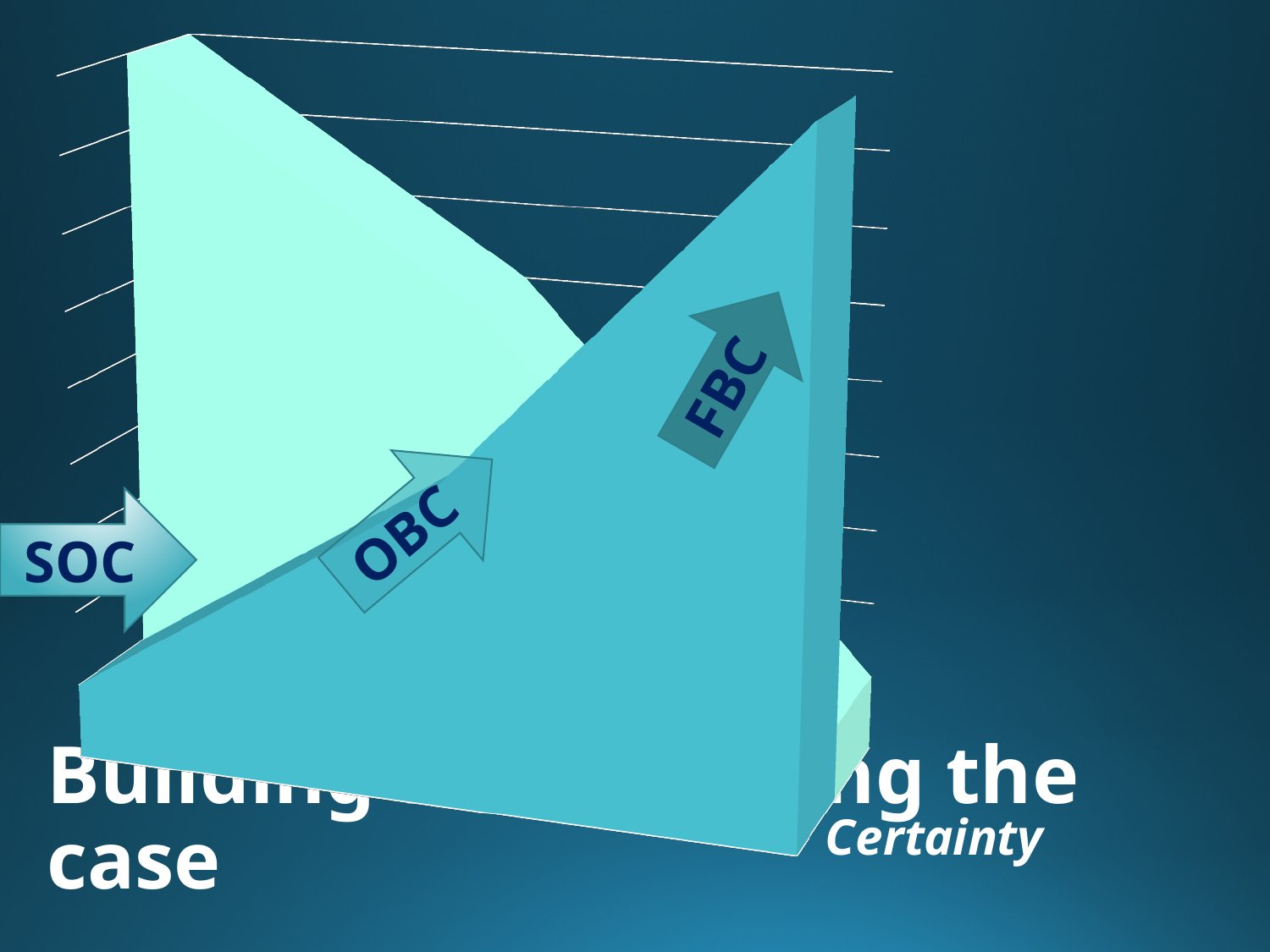
What kind of chart is shown on the slide? area chart Does the chart show a legend? No Does the back (lighter) series rise or fall from left to right? falls What are the three labels on the arrows overlaid on the chart, from left to right? SOC, OBC, FBC How many series are plotted on the chart? 2 Does the front (darker teal) series rise or fall from left to right? rises